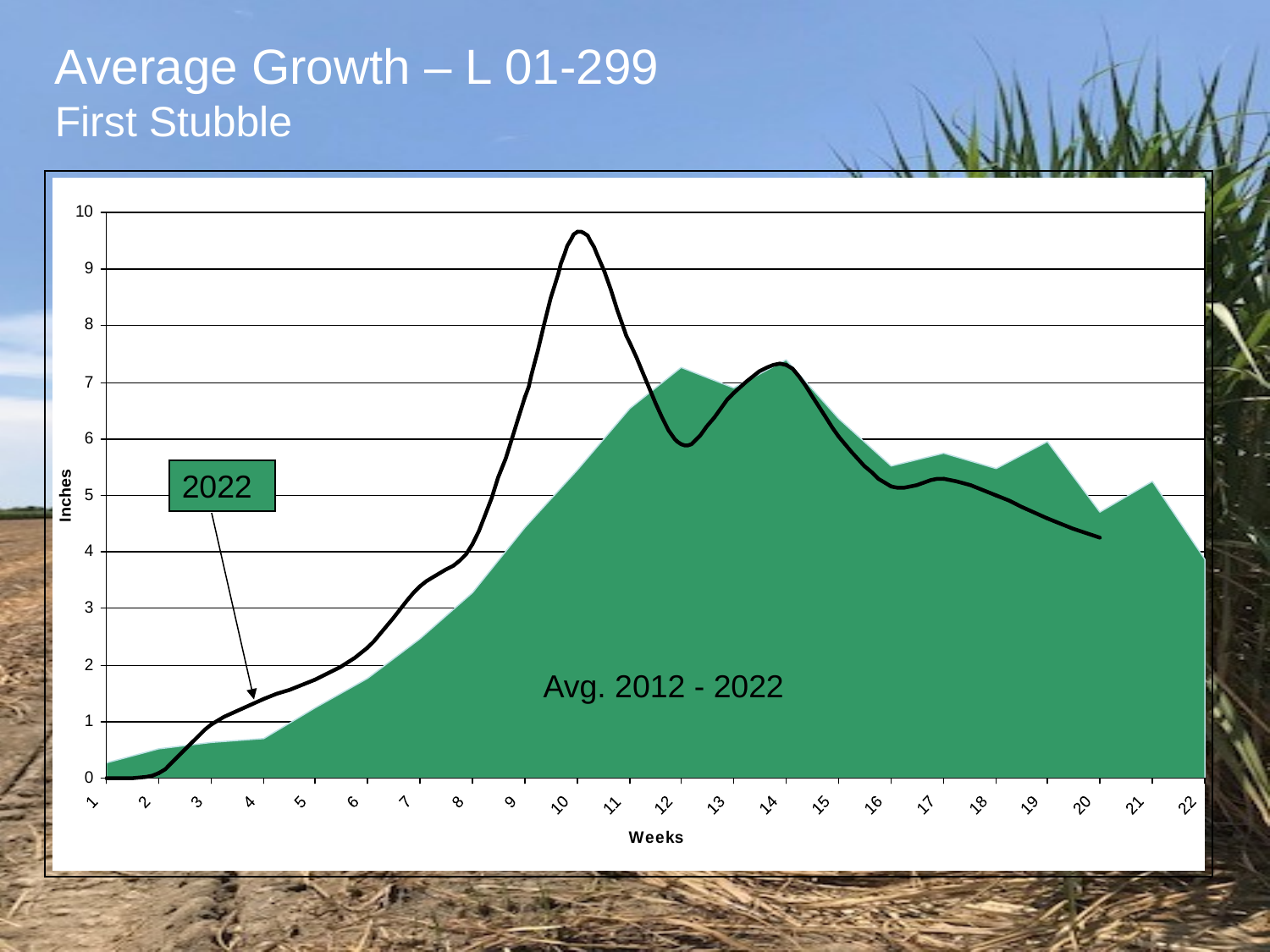
At week 10, which is higher: the 2022 line or the Avg. 2012 - 2022 area? 2022 In which week does the 2022 line reach its highest value? Week 10 Is the Avg. 2012 - 2022 value at week 22 greater or less than 5? less Is the 2022 value at week 9 greater or less than 6? greater Is the 2022 value at week 10 greater or less than 9? greater At week 19, which is higher: the 2022 line or the Avg. 2012 - 2022 area? Avg. 2012 - 2022 Does the 2022 line rise or fall from week 14 to week 20? fall How many weeks are shown on the x axis? 22 What is the label on the y axis of the chart? Inches How many data series are plotted on the chart? 2 What type of chart is shown on the slide? line and area chart